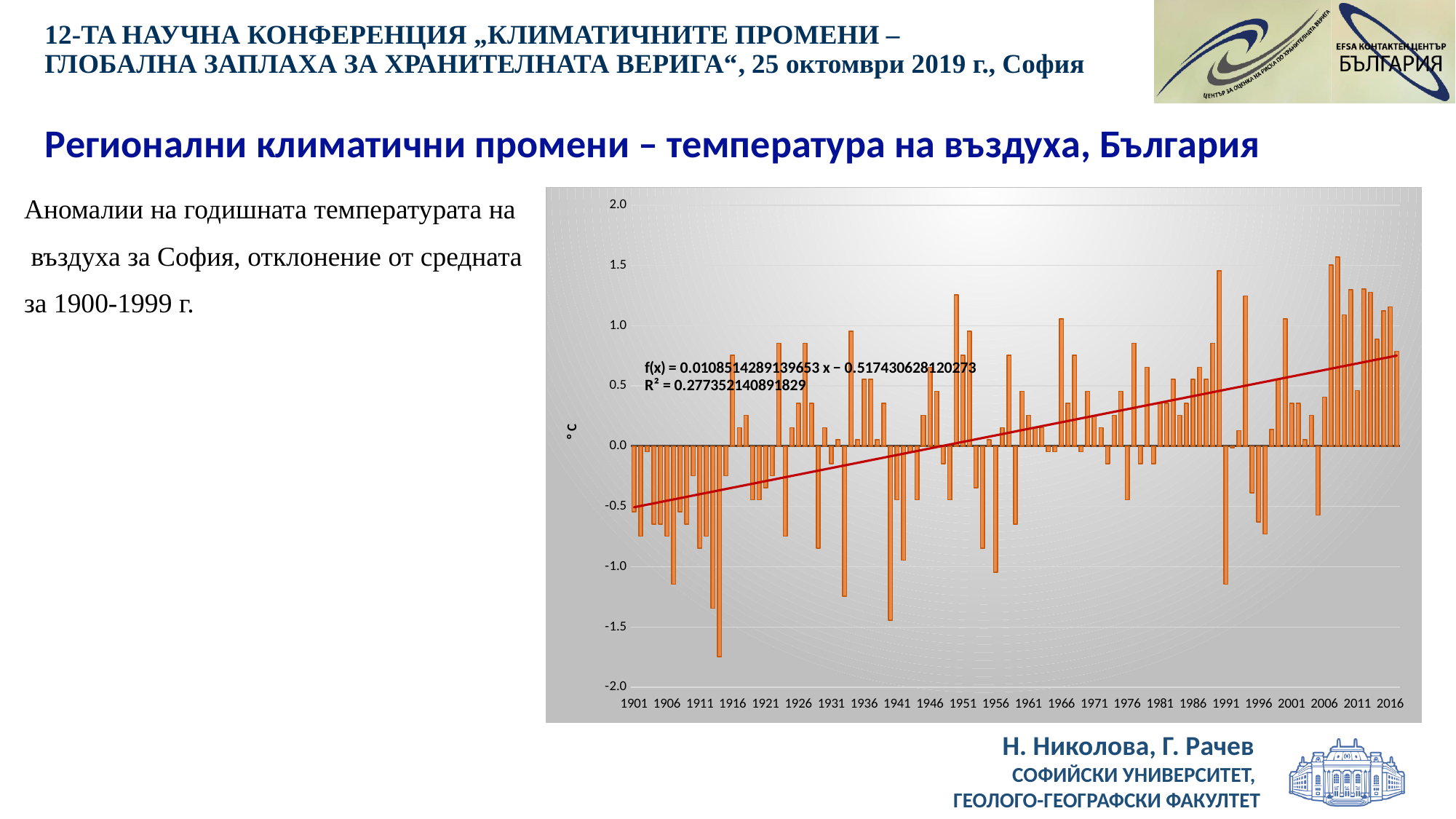
Which year has the lowest temperature anomaly on the chart? 1914 Is the value for 1934 greater or less than -1.0? greater Is the value for 1990 greater or less than 1.0? greater What is the R² value shown for the trend line? 0.277352140891829 Is the value for 1915 greater or less than -1.5? greater What kind of chart is shown on the slide? Bar chart What unit is shown on the y axis? °C Do the temperature anomaly values generally rise or fall from 1901 to 2016 according to the trend line? Rise How many year labels are shown on the x axis? 24